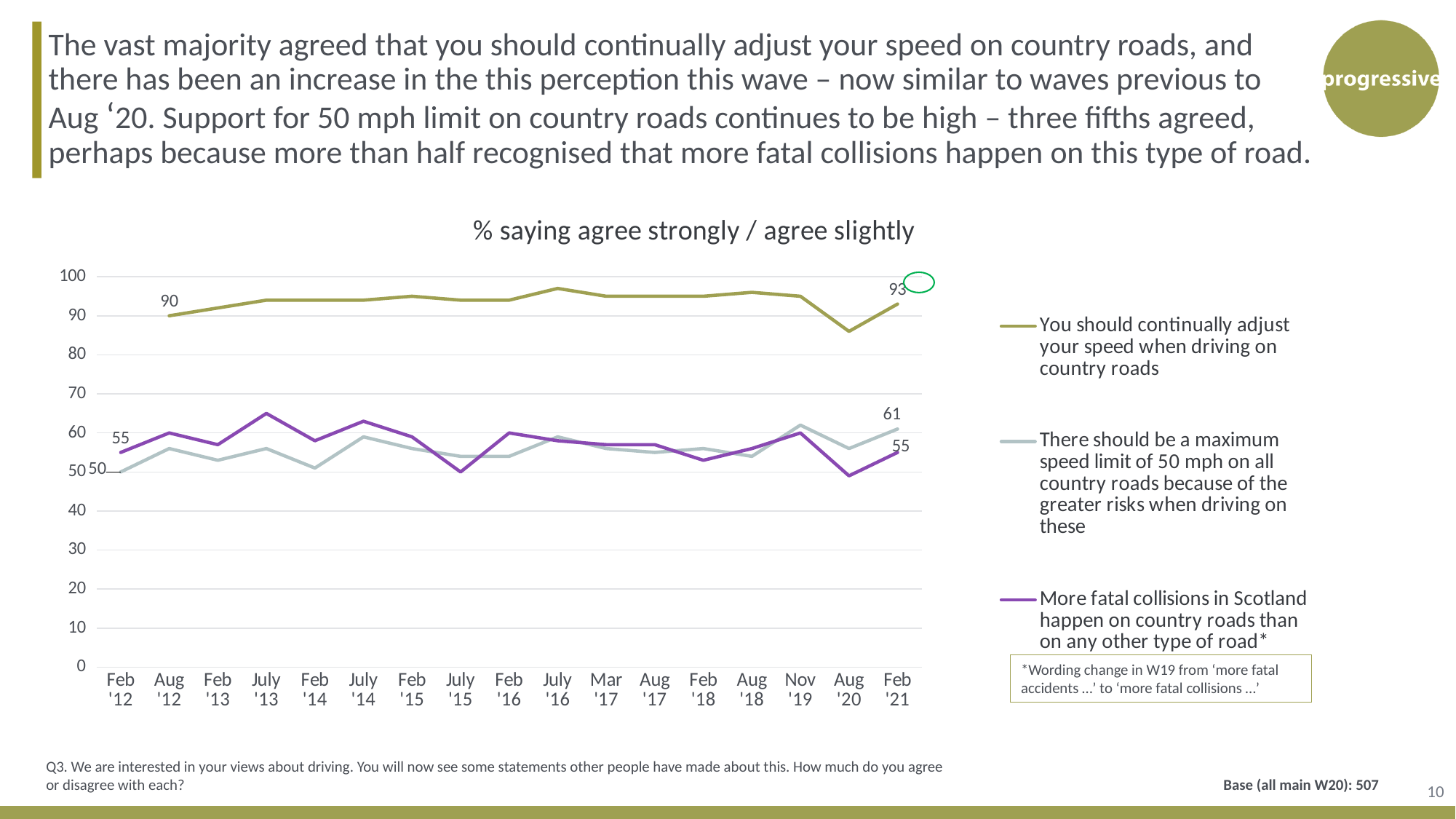
What is the difference between the Feb '21 and Aug '12 values for 'You should continually adjust your speed when driving on country roads'? 3 What is the value for 'You should continually adjust your speed when driving on country roads' at Feb '21? 93 Is the value for 'You should continually adjust your speed when driving on country roads' at Aug '20 greater or less than 90? less At Feb '21, which is larger: the value for the 50 mph speed limit statement or the value for the fatal collisions statement? the 50 mph speed limit statement What is the title of the chart? % saying agree strongly / agree slightly How many series does the legend list? 3 What is the value for 'There should be a maximum speed limit of 50 mph on all country roads' at Feb '21? 61 What is the value for 'There should be a maximum speed limit of 50 mph on all country roads' at Feb '12? 50 What is the value for 'More fatal collisions in Scotland happen on country roads than on any other type of road' at Feb '21? 55 What kind of chart is shown on the slide? line chart What is the value for 'You should continually adjust your speed when driving on country roads' at Aug '12? 90 By how much did the value for 'There should be a maximum speed limit of 50 mph on all country roads' change from Feb '12 to Feb '21? 11